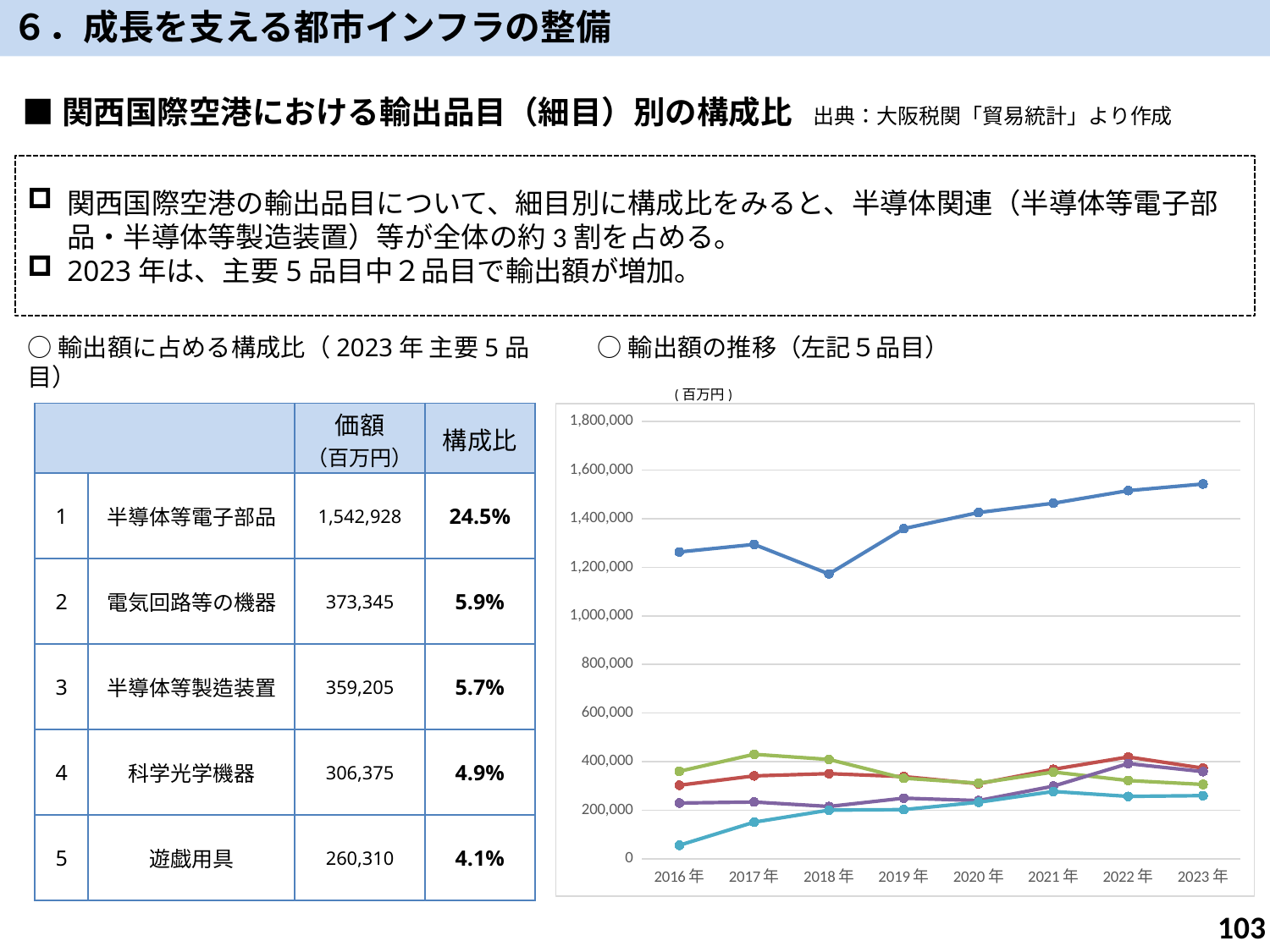
What kind of chart is shown on the right side of the slide (輸出額の推移)? line chart In the 輸出額の推移 chart, which line is higher in 2023年: the blue line or the red line? the blue line In the 輸出額の推移 chart, is the value of the blue line in 2023年 greater or less than 1,400,000? greater In the 輸出額の推移 chart, how many lines are plotted? 5 In the 輸出額の推移 chart, what is the first year shown on the x axis? 2016年 In the 輸出額の推移 chart, in which year does the blue line reach its highest value? 2023年 In the 輸出額の推移 chart, in which year does the blue line reach its lowest value? 2018年 In the 輸出額の推移 chart, is the value of the light blue (cyan) line in 2016年 greater or less than 200,000? less In the 輸出額の推移 chart, how many years are shown along the x axis? 8 In the 輸出額の推移 chart, what is the highest value shown on the y axis? 1,800,000 In the 輸出額の推移 chart, does the blue line rise or fall from 2018年 to 2023年? rise In the 輸出額の推移 chart, is the value of the blue line in 2018年 greater or less than 1,200,000? less